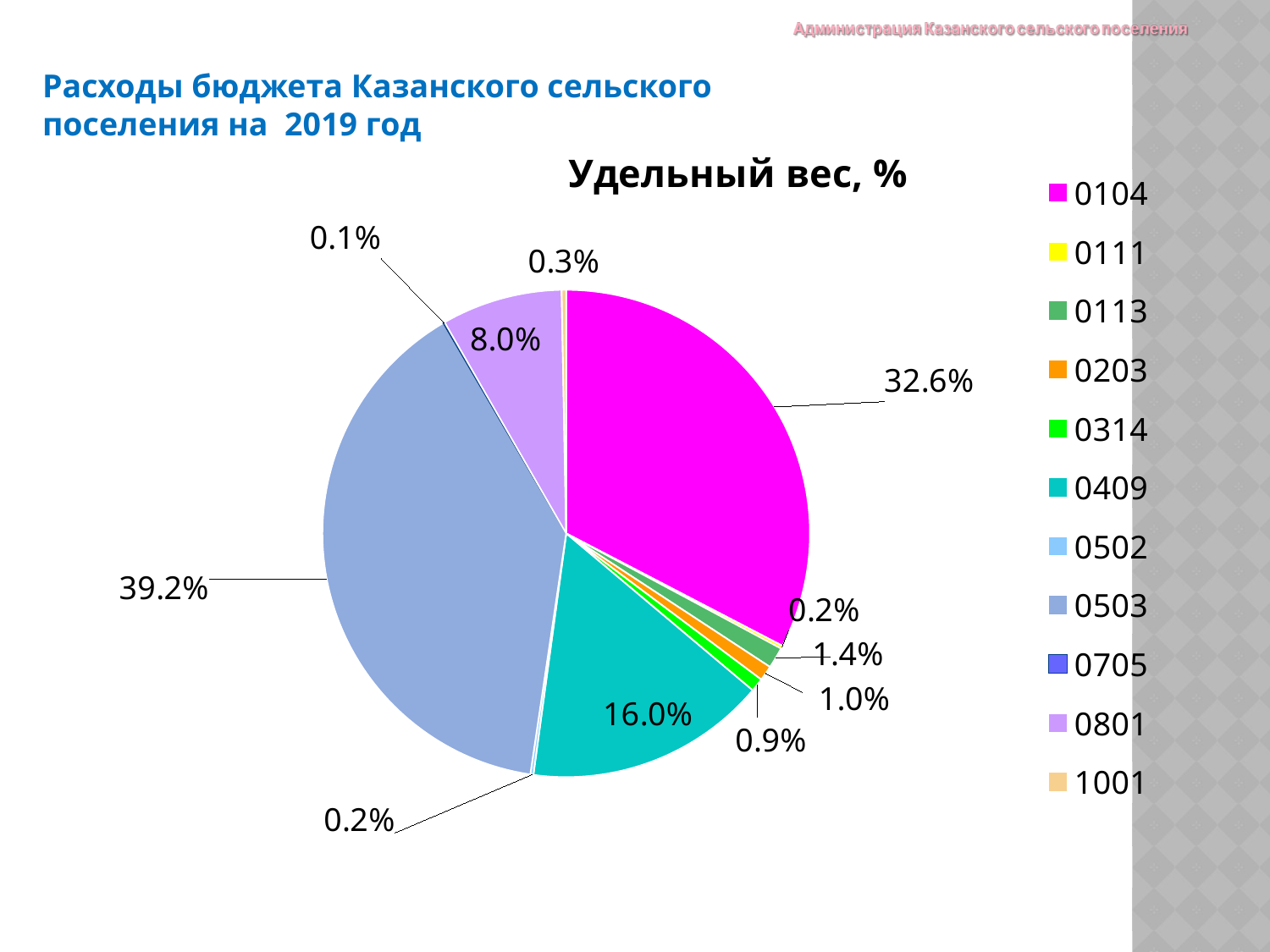
What is the share for 0801? 8.0% Which category has the smallest share of the pie? 0705 Which is larger, the share for 0409 or the share for 0801? 0409 What is the difference between the shares of 0503 and 0104? 6.6% What is the title of the chart? Удельный вес, % What is the share for 0113? 1.4% What is the share for 0409? 16.0% What type of chart is shown on the slide? pie chart How many series does the legend list? 11 What is the share for 0503? 39.2% What is the share for 0104? 32.6% Which category has the largest share of the pie? 0503